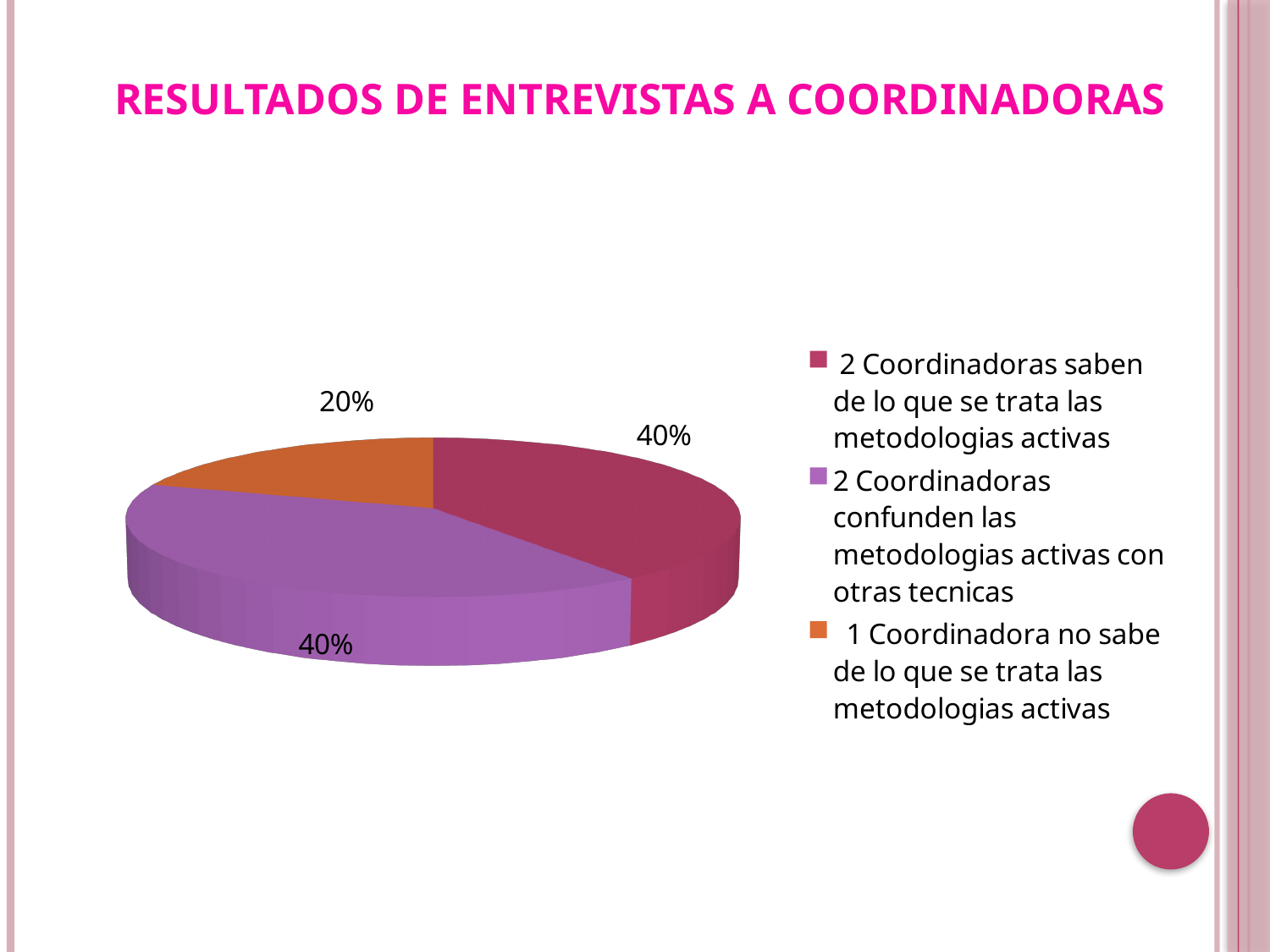
Which is larger: the slice for '2 Coordinadoras confunden las metodologias activas con otras tecnicas' or the slice for '1 Coordinadora no sabe de lo que se trata las metodologias activas'? 2 Coordinadoras confunden las metodologias activas con otras tecnicas What share of the pie corresponds to '1 Coordinadora no sabe de lo que se trata las metodologias activas'? 20% Which category has the smallest slice of the pie? 1 Coordinadora no sabe de lo que se trata las metodologias activas How many entries does the legend list? 3 What share of the pie corresponds to '2 Coordinadoras saben de lo que se trata las metodologias activas'? 40% What is the difference in percentage points between the slice for '2 Coordinadoras saben de lo que se trata las metodologias activas' and the slice for '1 Coordinadora no sabe de lo que se trata las metodologias activas'? 20 What colour is the slice for '1 Coordinadora no sabe de lo que se trata las metodologias activas'? orange What is the title of the slide containing the pie chart? RESULTADOS DE ENTREVISTAS A COORDINADORAS How many slices does the pie chart have? 3 What share of the pie corresponds to '2 Coordinadoras confunden las metodologias activas con otras tecnicas'? 40% What kind of chart is shown on the slide? pie chart